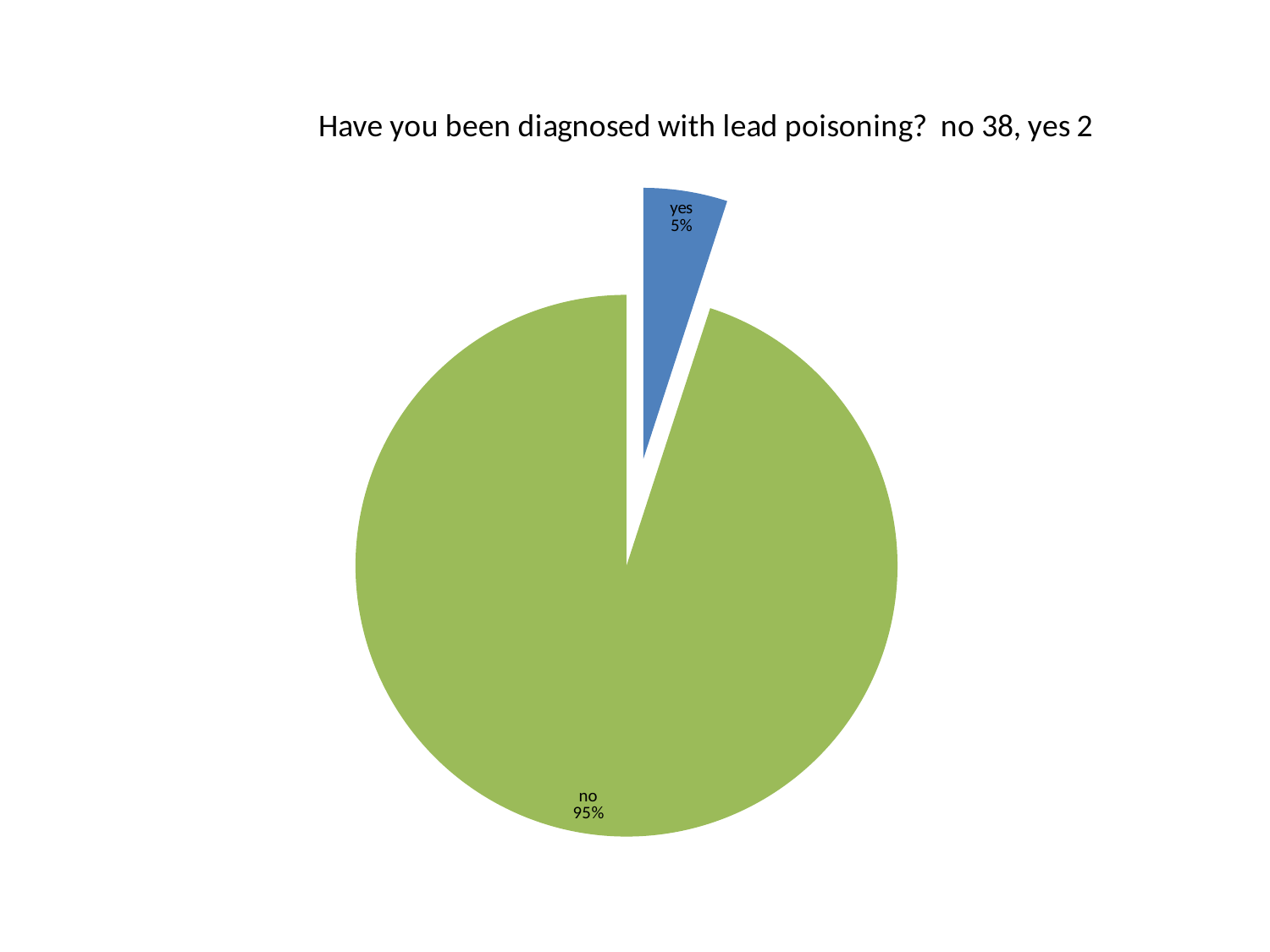
What is the title of the chart? Have you been diagnosed with lead poisoning? no 38, yes 2 What colour is the "yes" slice of the pie chart? blue According to the chart title, how many respondents answered "yes"? 2 What share of the pie does the "yes" slice represent? 5% Which slice is the smallest in the pie chart? yes Which slice is the largest in the pie chart? no What share of the pie does the "no" slice represent? 95% According to the chart title, how many respondents answered "no"? 38 What kind of chart is shown on the slide? pie chart What is the difference in percentage points between the "no" slice and the "yes" slice? 90 percentage points Which is larger, the "yes" slice or the "no" slice? no How many slices does the pie chart have? 2